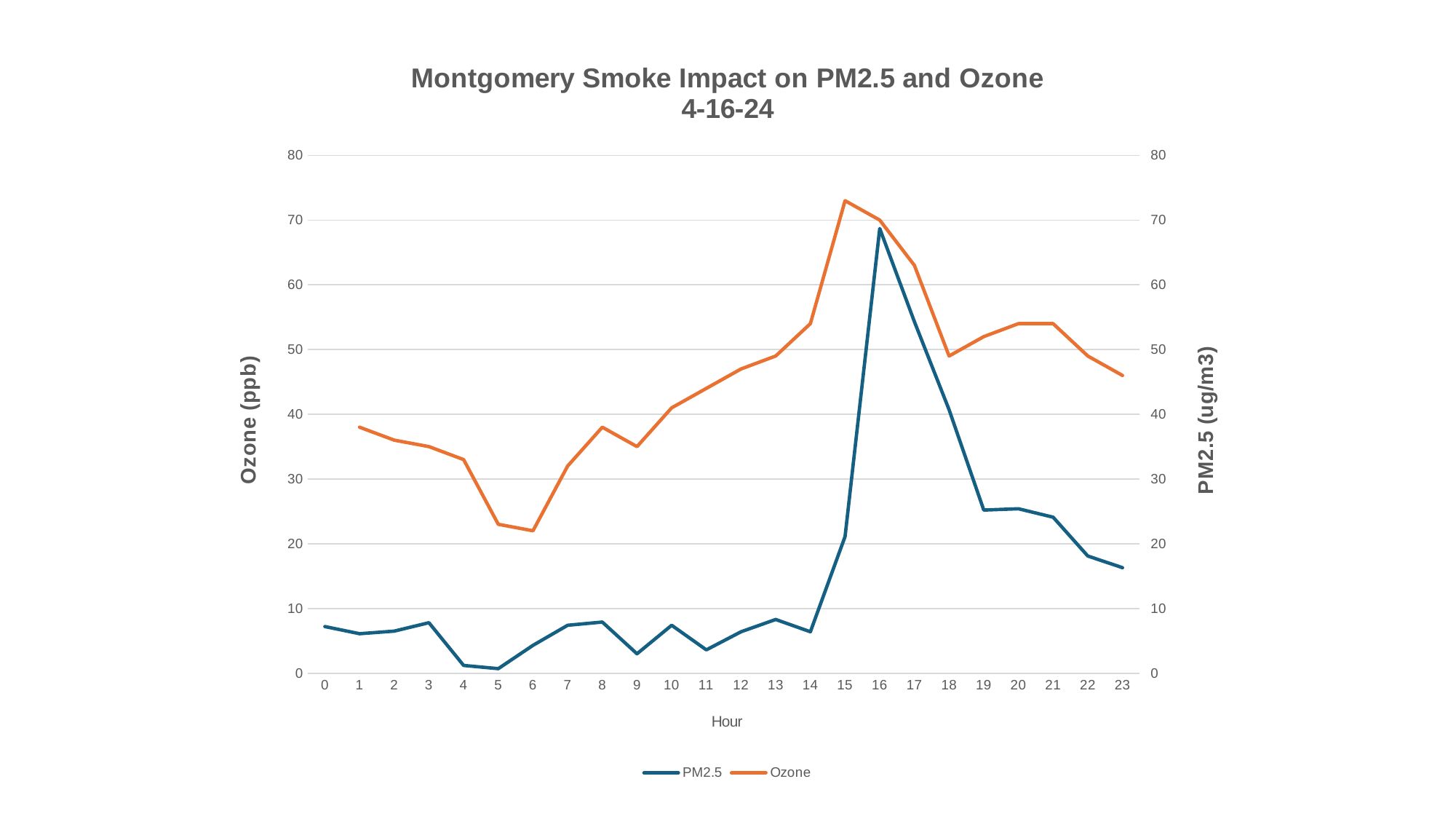
What is the title of the chart? Montgomery Smoke Impact on PM2.5 and Ozone 4-16-24 Which is larger, the Ozone value at hour 15 or at hour 18? Hour 15 How many series does the legend list? 2 Is the Ozone value at hour 6 greater or less than 30? less Is the Ozone value at hour 15 greater or less than 70? greater How many hours are plotted along the x axis? 24 What kind of chart is shown on the slide? Line chart Does the Ozone series rise or fall between hour 6 and hour 15? Rise Does the PM2.5 series rise or fall between hour 16 and hour 23? Fall At which hour does the PM2.5 series reach its highest value? 16 Is the PM2.5 value at hour 16 greater or less than 60? greater At which hour does the Ozone series reach its highest value? 15